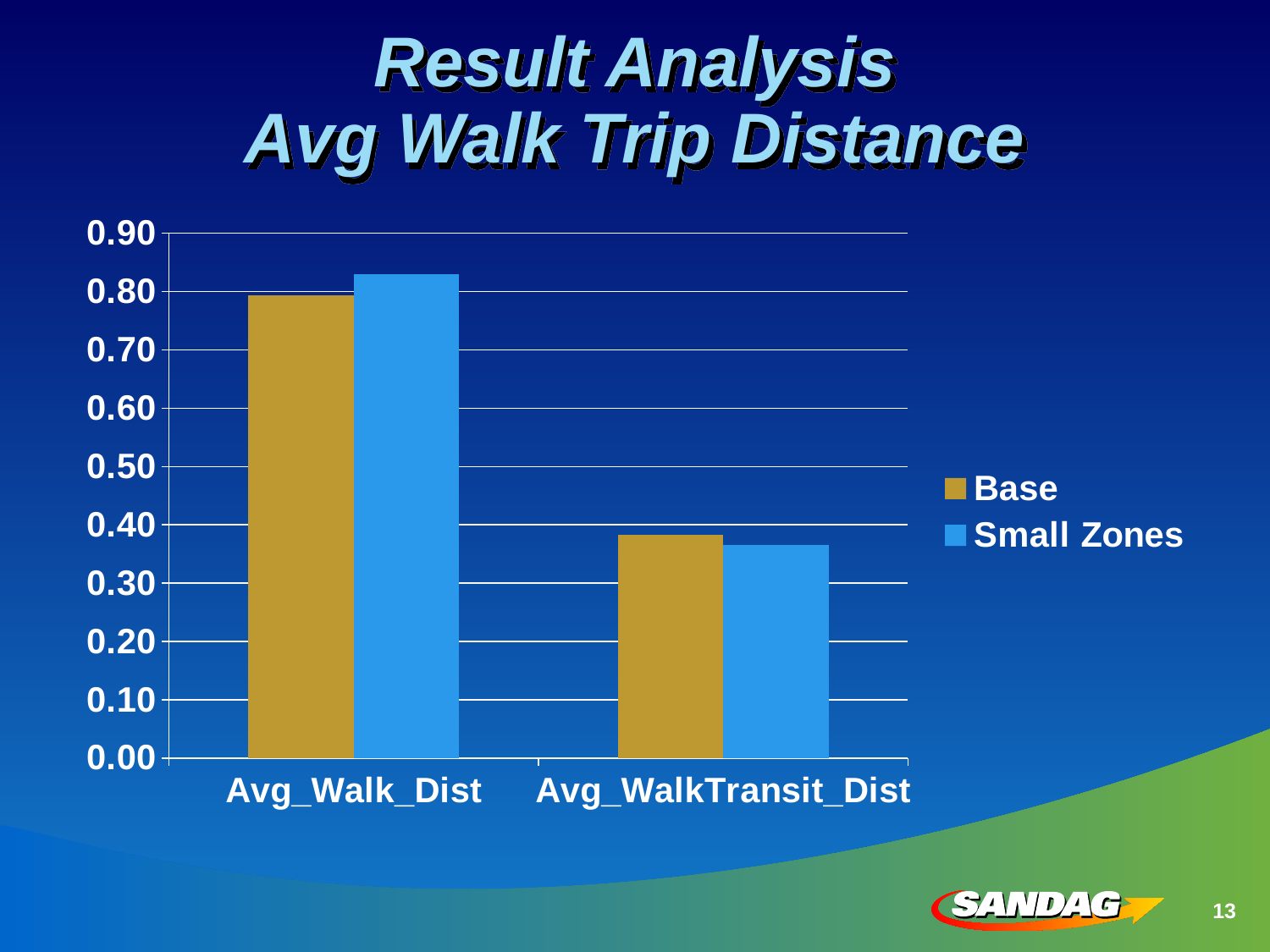
Which category has the higher Base value? Avg_Walk_Dist Is the Base value for Avg_Walk_Dist greater or less than 0.70? greater Is the Small Zones value for Avg_Walk_Dist greater or less than 0.80? greater For Avg_Walk_Dist, which series has the larger value, Base or Small Zones? Small Zones What is the title of the chart on the slide? Result Analysis Avg Walk Trip Distance Which category has the lower Small Zones value? Avg_WalkTransit_Dist How many categories are shown on the x axis of the chart? 2 What are the two series named in the chart's legend? Base and Small Zones What kind of chart is shown on the slide? bar chart How many series does the chart's legend list? 2 Is the Small Zones value for Avg_WalkTransit_Dist greater or less than 0.30? greater